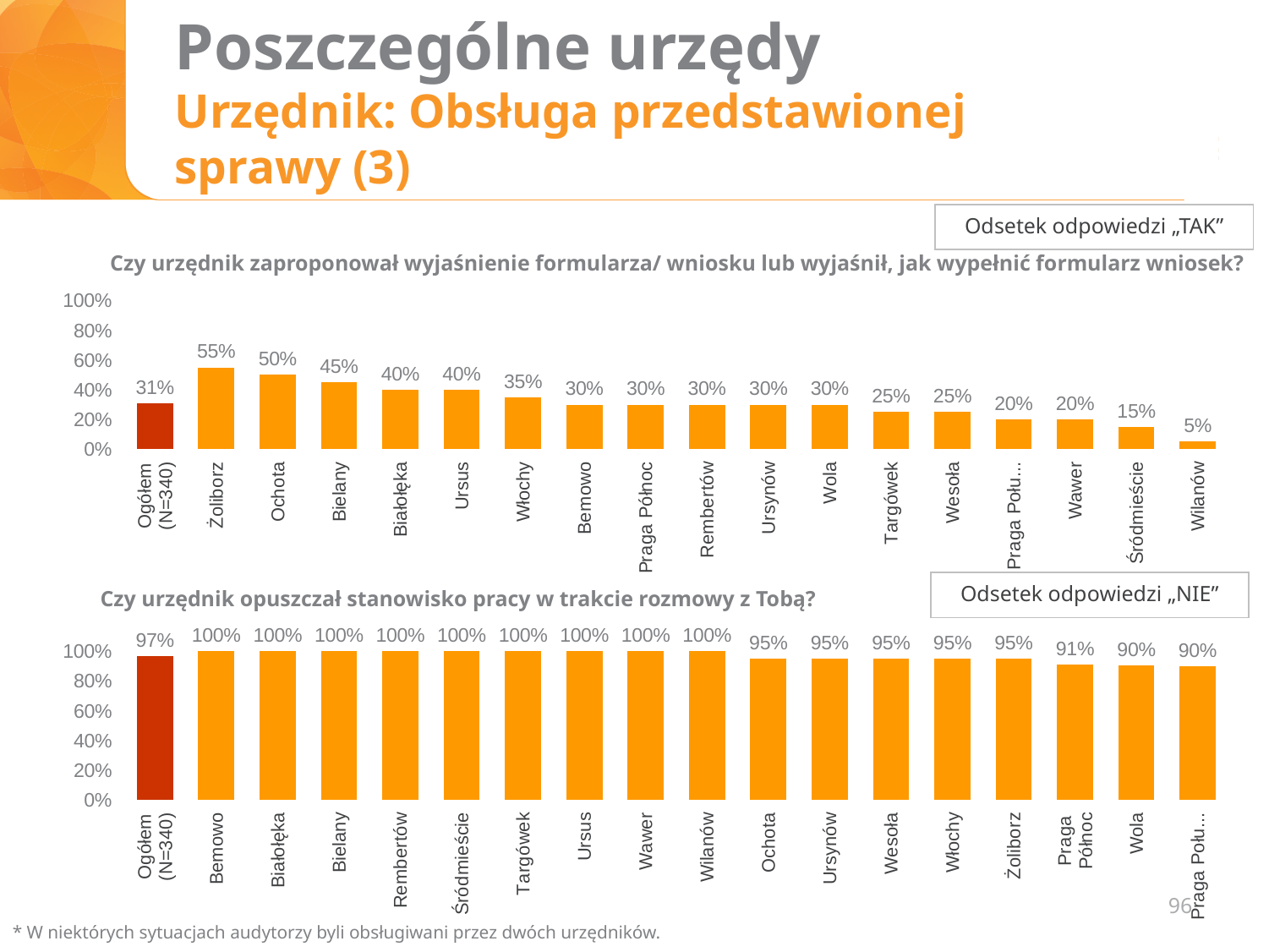
In the top chart, which is larger, the value for Bielany or the value for Wawer? Bielany What does the label box above the bottom chart say? Odsetek odpowiedzi „NIE” In the top chart, what is the value for Ogółem (N=340)? 31% In the top chart, which district has the lowest value? Wilanów In the bottom chart, what is the value for Ogółem (N=340)? 97% In the bottom chart, what is the value for Praga Północ? 91% In the bottom chart, what is the difference between Bemowo and Wola? 10% What type of chart is the top chart? Bar chart In the top chart, what is the difference between Ochota and Śródmieście? 35% In the top chart, which district has the highest value? Żoliborz In the top chart, what is the value for Żoliborz? 55% How many bars are shown in the bottom chart? 18